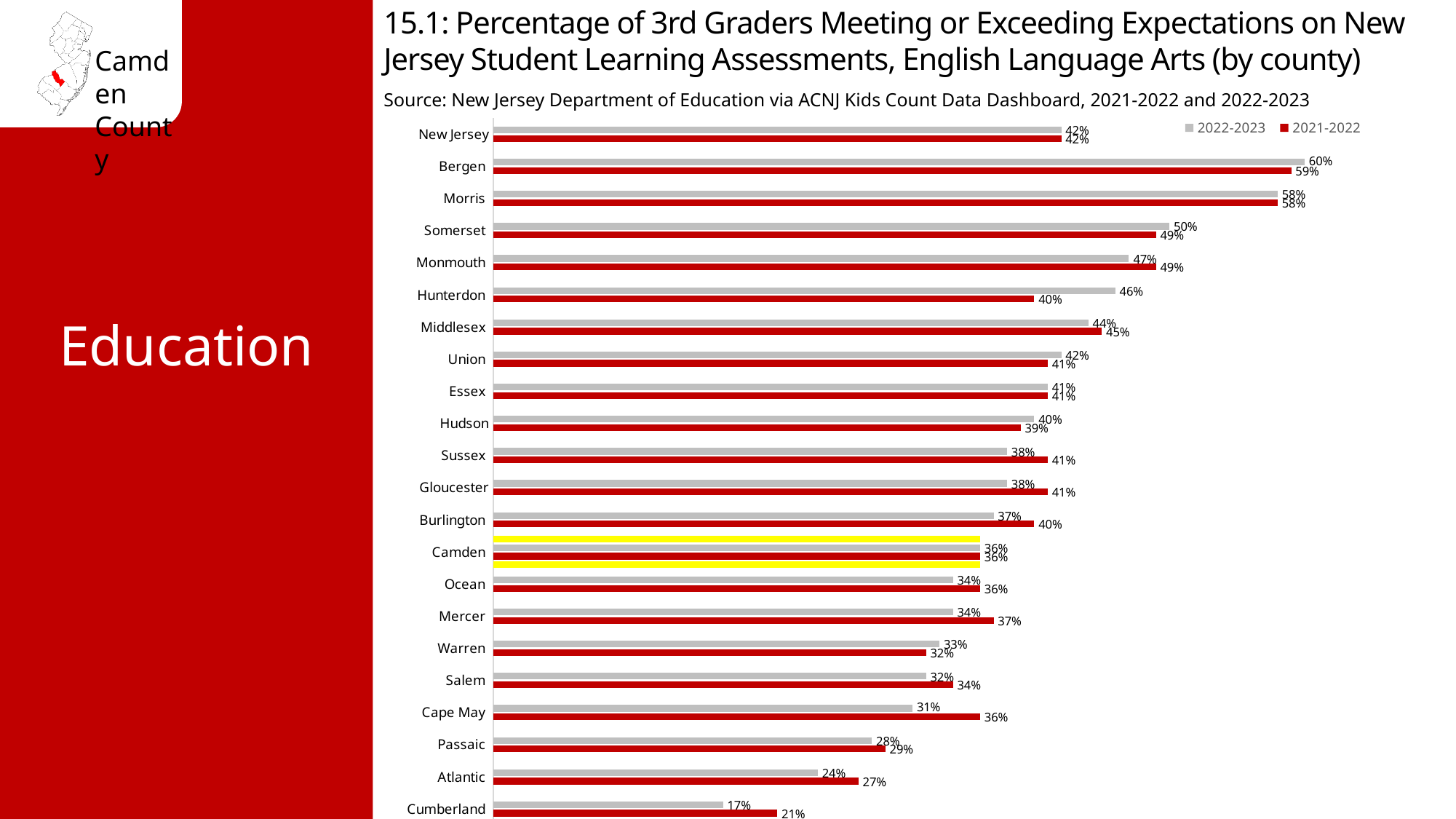
What is the 2022-2023 value for Camden? 36% How many counties or regions are listed on the chart? 22 How many series does the legend list? 2 What is the difference between the 2022-2023 values for Bergen and Cumberland? 43% What is the 2021-2022 value for Hunterdon? 40% Which series is shown in red in the legend? 2021-2022 Which county has the highest 2022-2023 value? Bergen What kind of chart is shown on the slide? Bar chart Which county has the lowest 2021-2022 value? Cumberland Which is larger for Cape May: the 2022-2023 value or the 2021-2022 value? 2021-2022 What is the difference between the 2022-2023 and 2021-2022 values for Hunterdon? 6% What is the 2022-2023 value for Cumberland? 17%